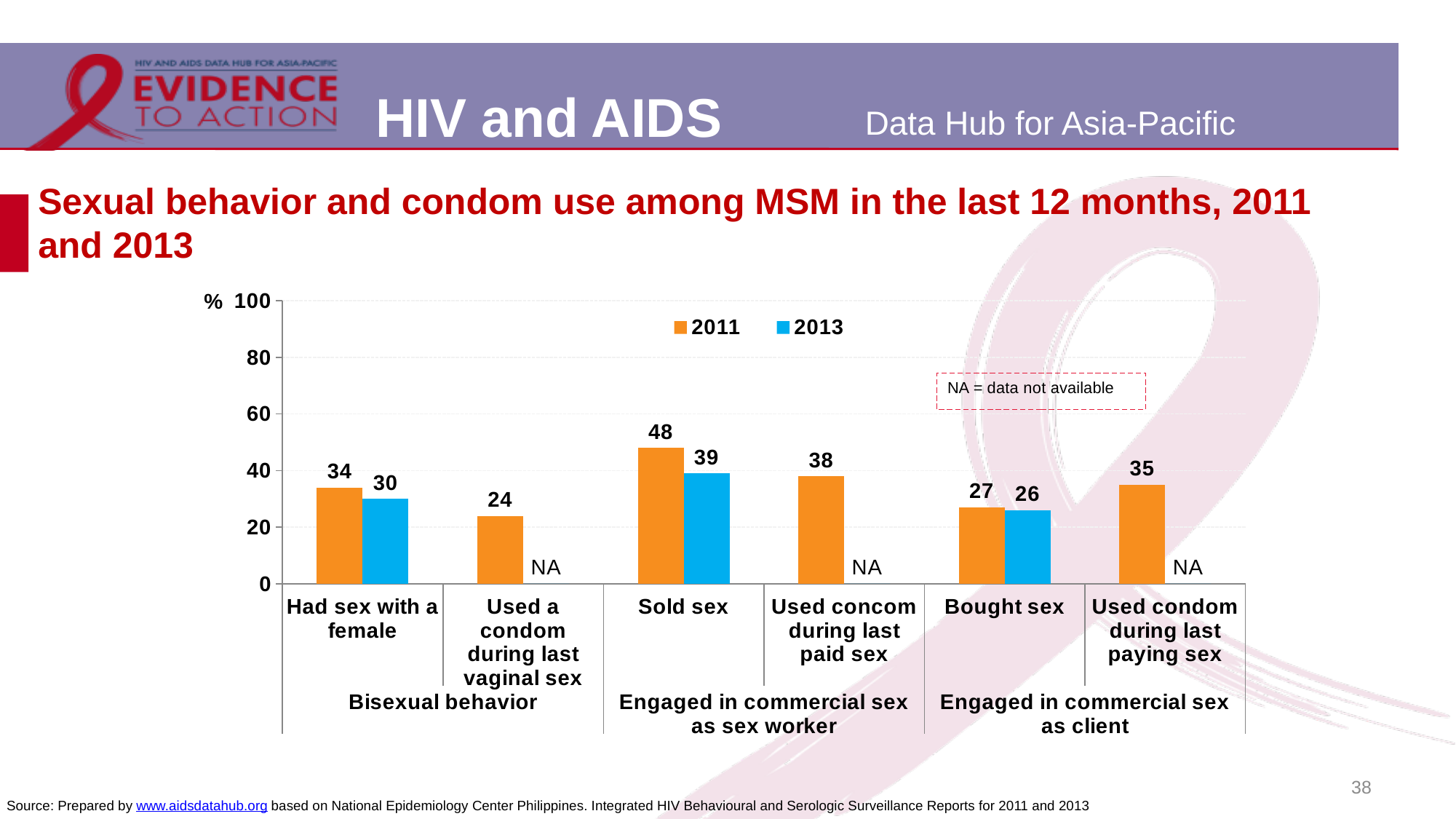
How many series does the legend list? 2 What is the 2011 value for "Had sex with a female"? 34 What is the 2011 value for "Used condom during last paying sex"? 35 What is the difference between the 2011 and 2013 values for "Sold sex"? 9 What does "NA" stand for according to the note on the chart? Data not available How many categories are shown on the x axis? 6 Which is larger: the 2011 value for "Used concom during last paid sex" or the 2011 value for "Bought sex"? Used concom during last paid sex What is the 2013 value for "Sold sex"? 39 Which category has the highest 2011 value? Sold sex What kind of chart is shown on the slide? Bar chart What is the 2013 value for "Bought sex"? 26 Which category has the lowest 2011 value? Used a condom during last vaginal sex